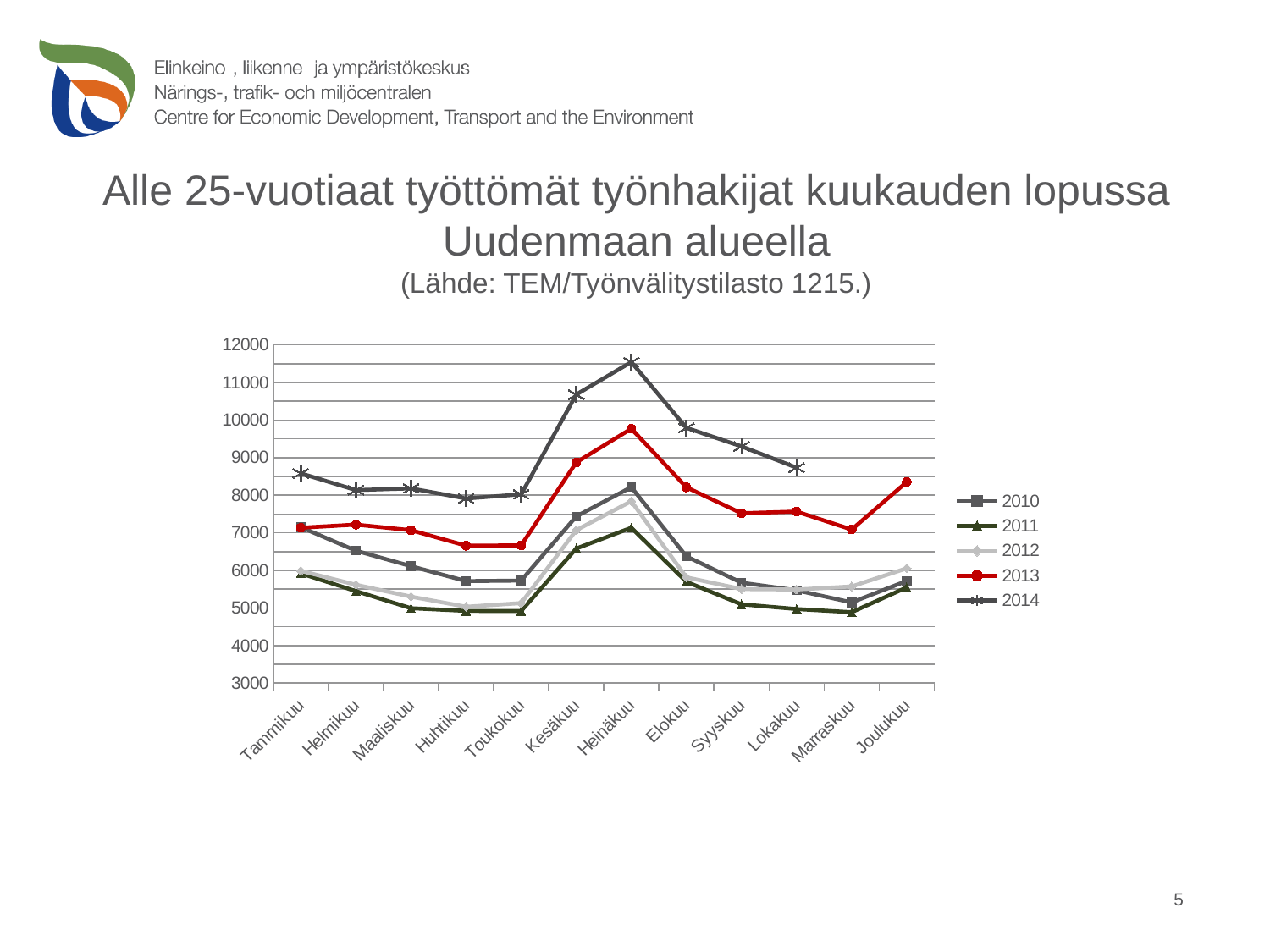
What kind of chart is shown on the slide? line chart Which series has the lowest value in Heinäkuu? 2011 Is the 2013 value for Tammikuu greater or less than 8000? less Is the 2014 value for Lokakuu greater or less than 9000? less In which month does the 2014 series reach its highest value? Heinäkuu Does the 2014 series rise or fall from Heinäkuu to Lokakuu? fall In Maaliskuu, which is larger: the 2011 value or the 2012 value? 2012 Is the 2014 value for Heinäkuu greater or less than 11000? greater In which month does the 2013 series reach its highest value? Heinäkuu How many series does the legend list? 5 How many months are shown on the x axis? 12